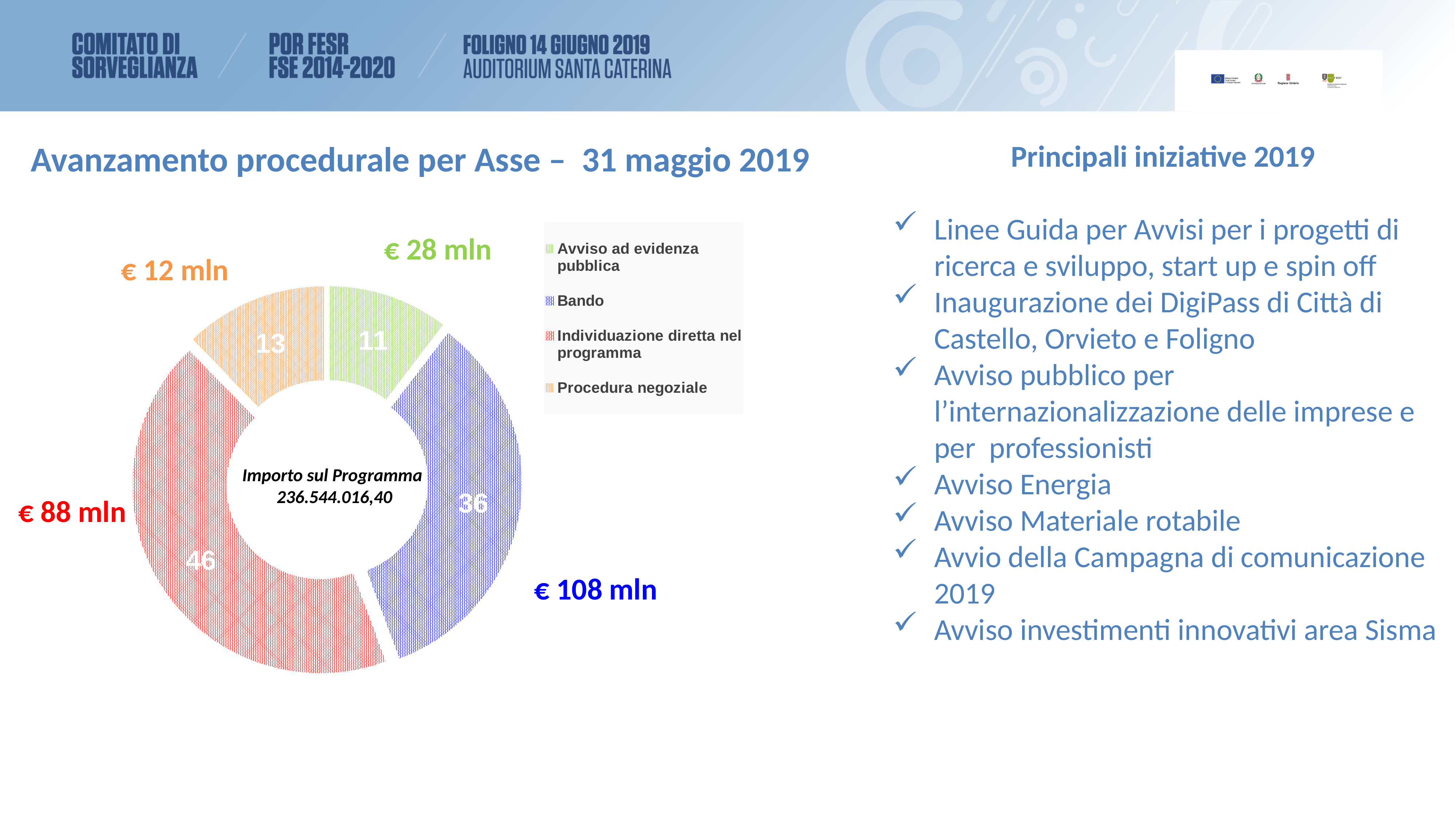
What is the difference between the data labels of Individuazione diretta nel programma and Bando? 10 How many categories does the legend of the doughnut chart list? 4 What is the data label on the Avviso ad evidenza pubblica segment? 11 What amount is printed in the centre of the doughnut chart under 'Importo sul Programma'? 236.544.016,40 What is the data label on the Bando segment of the doughnut chart? 36 What kind of chart is shown on the slide? doughnut chart What euro amount is shown next to the Bando segment? € 108 mln Which category has the smallest segment in the doughnut chart? Avviso ad evidenza pubblica What is the data label on the Procedura negoziale segment? 13 What is the data label on the Individuazione diretta nel programma segment? 46 Which segment is larger, Procedura negoziale or Avviso ad evidenza pubblica? Procedura negoziale Which category has the largest segment in the doughnut chart? Individuazione diretta nel programma